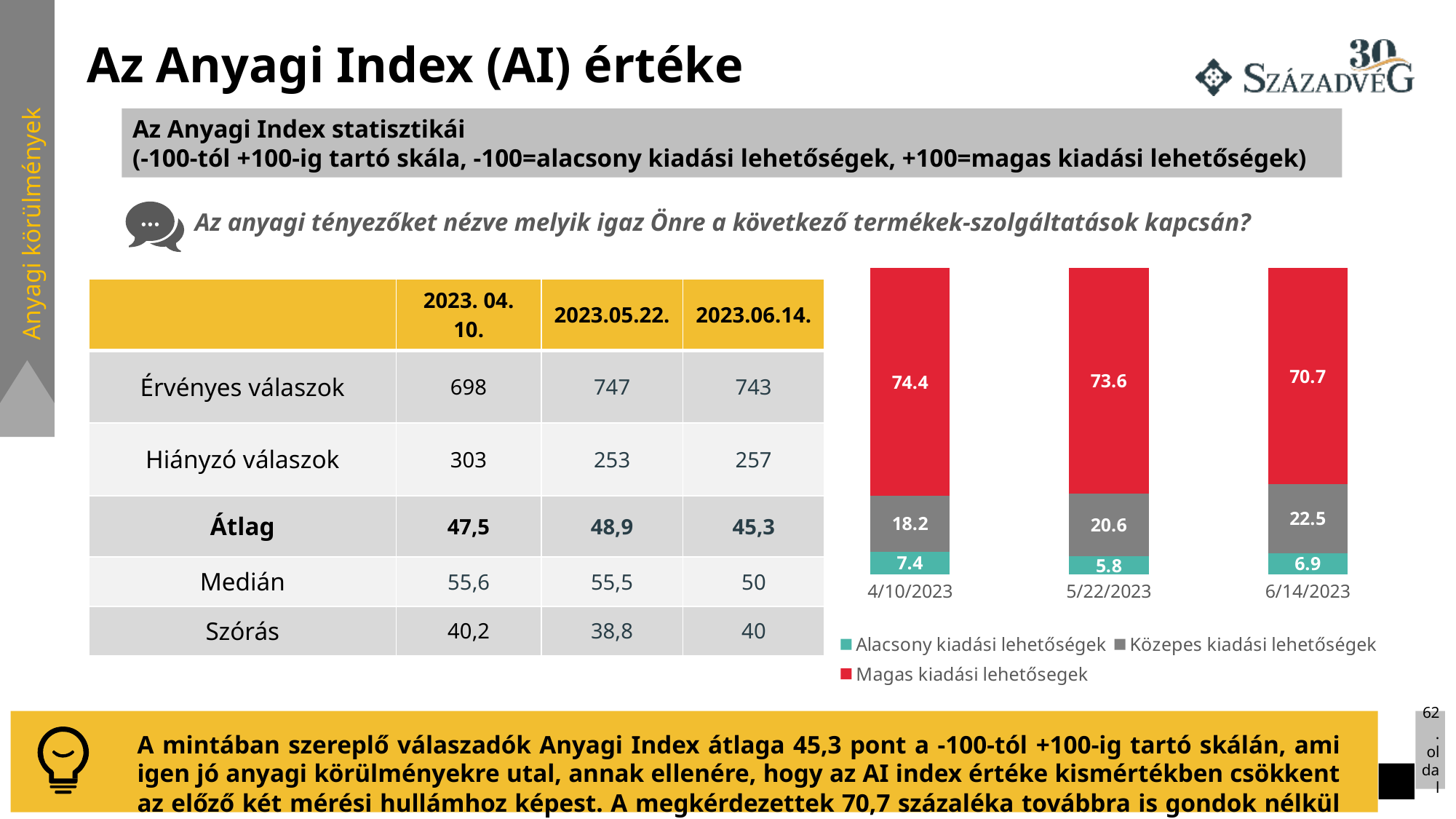
What is the value of 'Közepes kiadási lehetőségek' for 6/14/2023? 22.5 What type of chart is shown on the right side of the slide? stacked bar chart On which date is the 'Magas kiadási lehetőségek' value the lowest? 6/14/2023 How many dates (bars) are shown on the chart's x axis? 3 What is the value of 'Alacsony kiadási lehetőségek' for 5/22/2023? 5.8 Which colour represents 'Magas kiadási lehetőségek' in the chart? red Which is larger: the 'Alacsony kiadási lehetőségek' value for 4/10/2023 or for 6/14/2023? 4/10/2023 On which date is the 'Közepes kiadási lehetőségek' value the highest? 6/14/2023 How many series does the chart legend list? 3 Does the 'Közepes kiadási lehetőségek' value rise or fall across the three dates from left to right? rise What is the value of 'Magas kiadási lehetőségek' for 4/10/2023? 74.4 What is the difference between the 'Magas kiadási lehetőségek' values for 4/10/2023 and 6/14/2023? 3.7